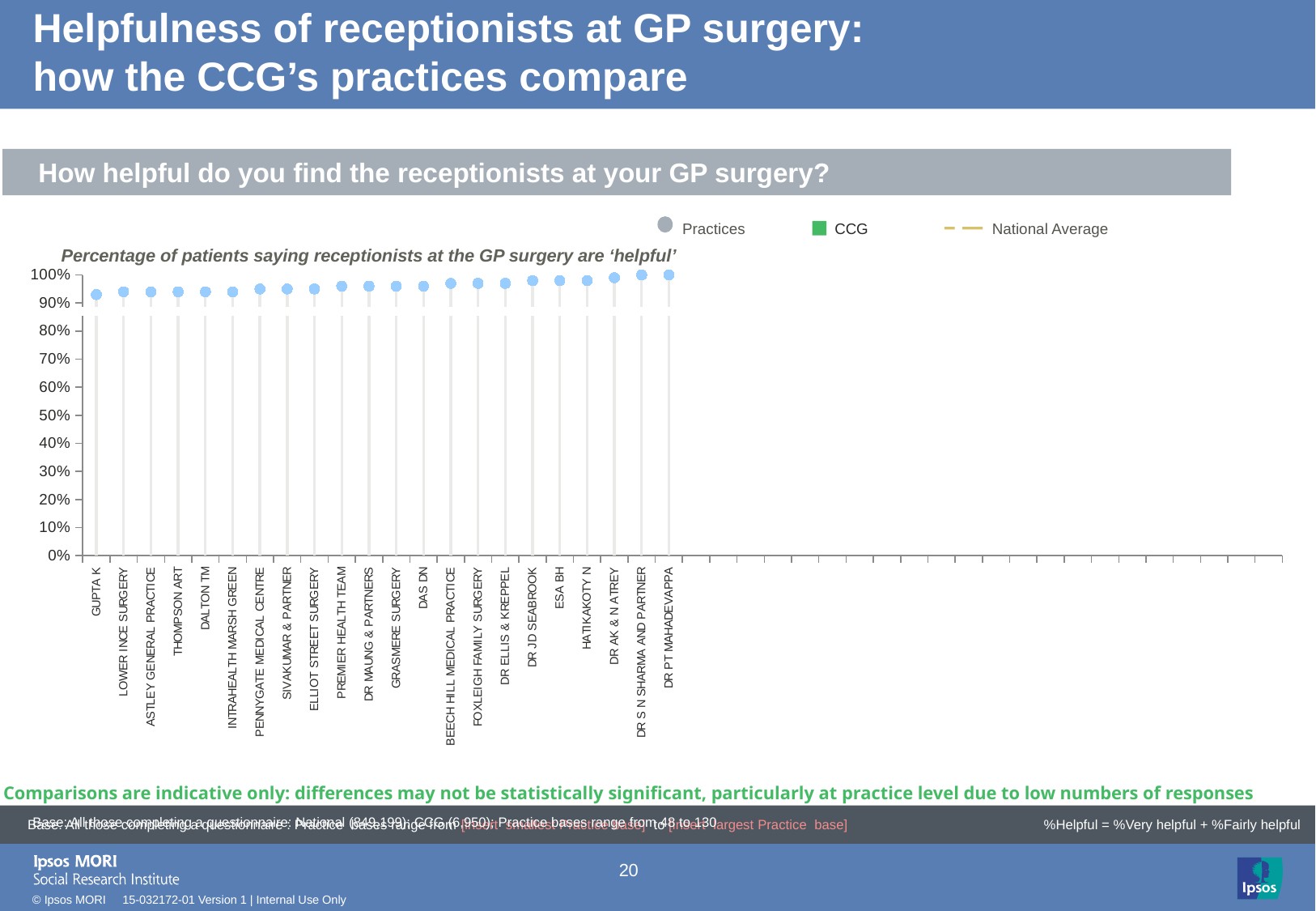
Do the plotted values rise or fall moving from left to right along the x axis? rise What is the subtitle printed above the chart describing what is plotted? Percentage of patients saying receptionists at the GP surgery are 'helpful' Which has the larger value, LOWER INCE SURGERY or DR S N SHARMA AND PARTNER? DR S N SHARMA AND PARTNER What is the first practice listed on the x axis? GUPTA K Is the value for DALTON TM greater or less than 80%? greater Which has the larger value, GUPTA K or DR PT MAHADEVAPPA? DR PT MAHADEVAPPA How many practices are plotted on the chart? 22 What are the three entries in the chart legend? Practices, CCG, National Average Is the value for DR PT MAHADEVAPPA greater or less than 90%? greater How many entries does the chart legend list? 3 Is the value for GUPTA K greater or less than 90%? greater